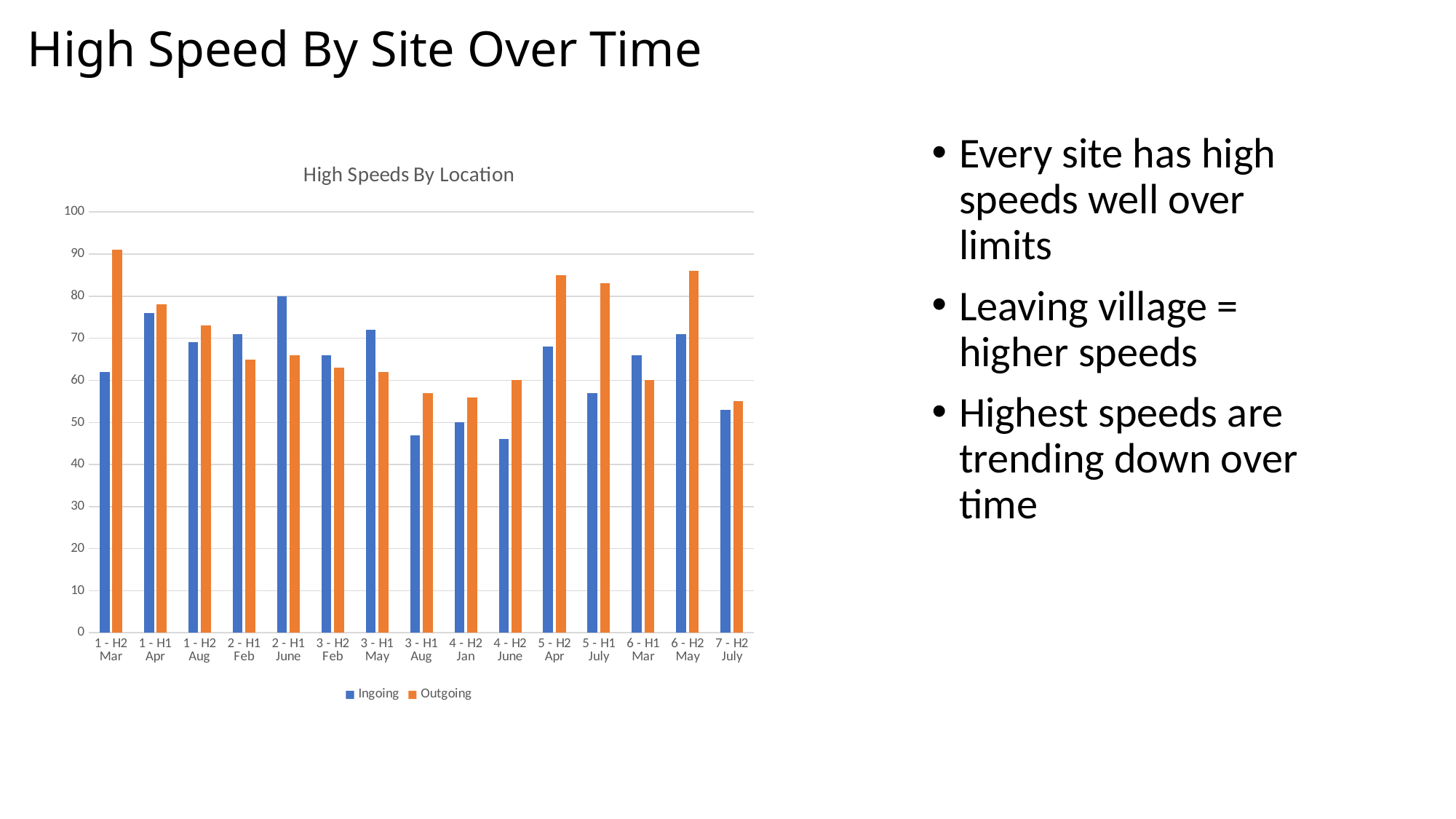
What is the title of the chart? High Speeds By Location Which category has the highest Outgoing value? 1 - H2 Mar Is the Outgoing value for 5 - H2 Apr greater or less than 80? greater Is the Outgoing value for 1 - H2 Mar greater or less than 80? greater How many categories are shown along the x axis of the chart? 15 What kind of chart is shown on the slide? Bar chart How many series does the chart legend list? 2 For 2 - H1 June, which is larger, the Ingoing or the Outgoing value? Ingoing Which series is shown in orange in the chart? Outgoing For 1 - H2 Mar, which is larger, the Ingoing or the Outgoing value? Outgoing Is the Ingoing value for 4 - H2 June greater or less than 50? less Which category has the highest Ingoing value? 2 - H1 June